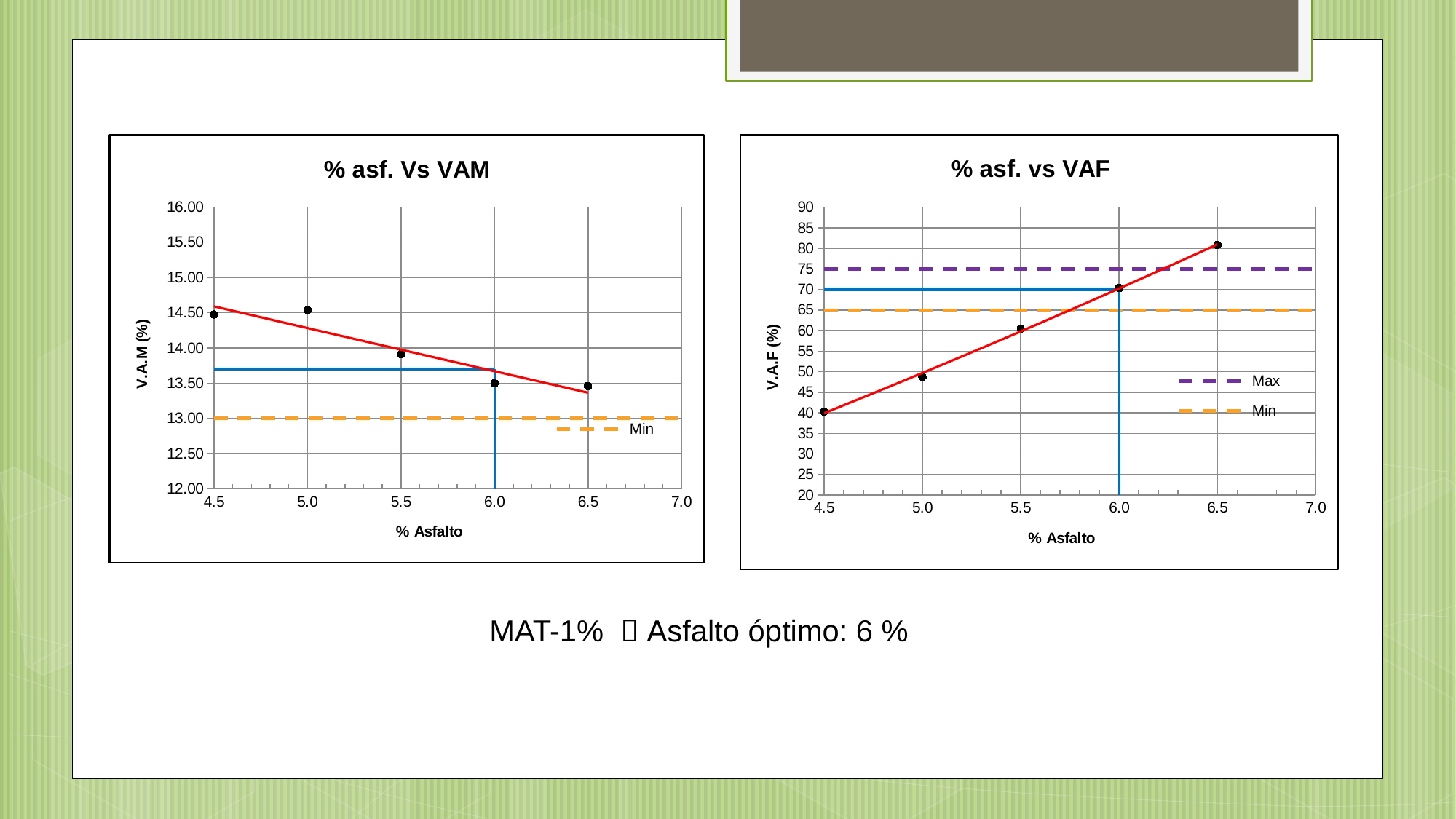
In the '% asf. Vs VAM' chart, do the V.A.M values generally rise or fall as % Asfalto increases? fall In the '% asf. vs VAF' chart, at what V.A.F value is the dashed 'Max' line drawn? 75 In the '% asf. Vs VAM' chart, which has the larger V.A.M value: 5.0 or 6.5 % Asfalto? 5.0 In the '% asf. vs VAF' chart, which % Asfalto value has the highest V.A.F? 6.5 Which entries does the legend of the '% asf. vs VAF' chart list? Max, Min In the '% asf. vs VAF' chart, which % Asfalto value has the lowest V.A.F? 4.5 In the '% asf. Vs VAM' chart, is the V.A.M value at 4.5 % Asfalto greater or less than 14.00? greater How many data points are plotted in the '% asf. vs VAF' chart? 5 In the '% asf. vs VAF' chart, is the V.A.F value at 4.5 % Asfalto greater or less than 45? less In the '% asf. vs VAF' chart, do the V.A.F values rise or fall as % Asfalto increases? rise What kind of chart is the '% asf. Vs VAM' chart? scatter chart In the '% asf. vs VAF' chart, is the V.A.F value at 5.5 % Asfalto greater or less than 55? greater